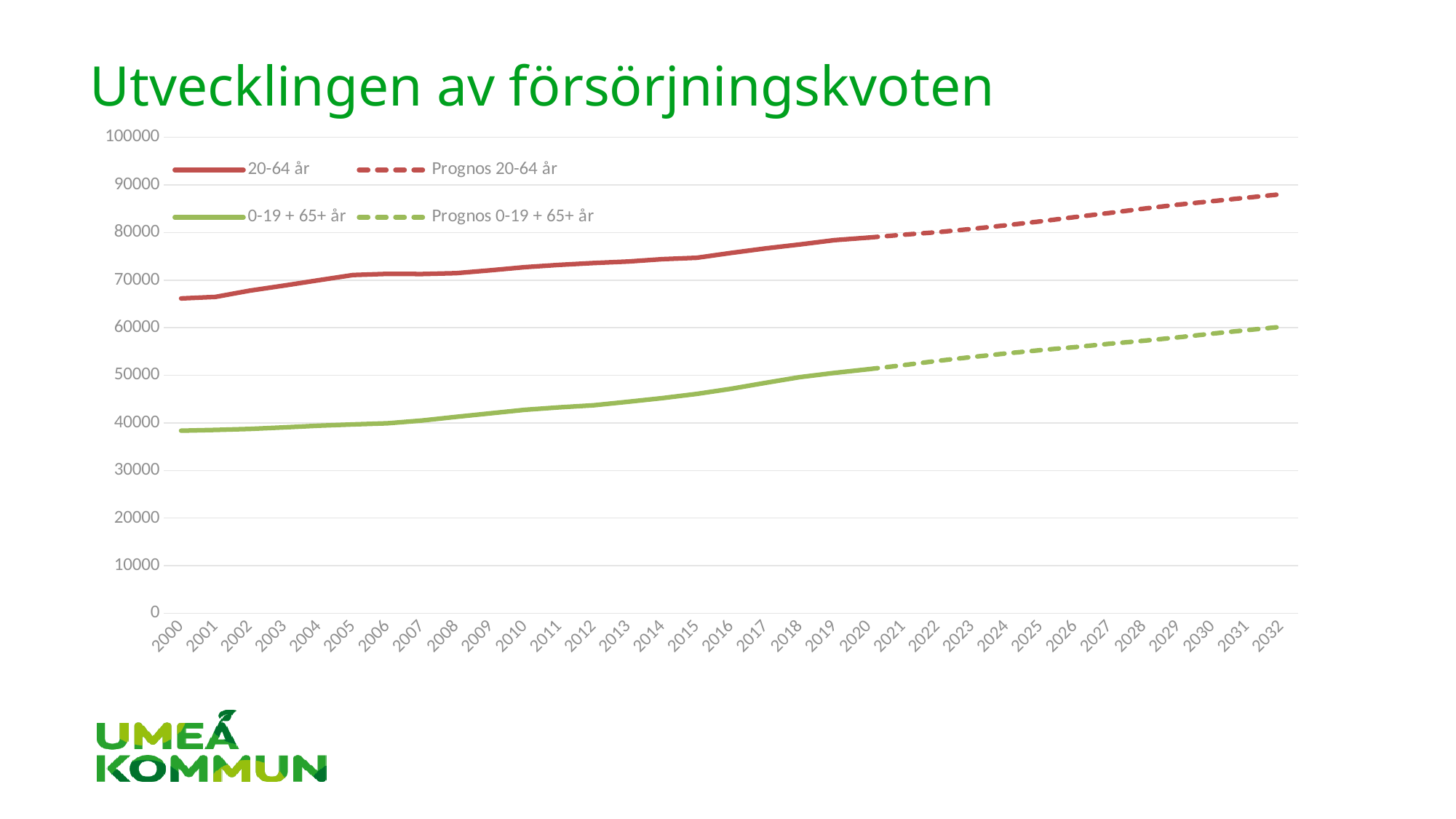
How many series does the legend list? 4 Is the value for Prognos 20-64 år in 2032 greater or less than 80000? greater Which legend entry is drawn as a dashed red line? Prognos 20-64 år Does the 0-19 + 65+ år line rise or fall from 2000 to 2020? rise Does the 20-64 år line rise or fall from 2000 to 2020? rise In 2010, which is larger: the value for 20-64 år or the value for 0-19 + 65+ år? 20-64 år How many years are shown on the x axis? 33 What is the title of the slide? Utvecklingen av försörjningskvoten Is the value for Prognos 0-19 + 65+ år in 2032 greater or less than 50000? greater Is the value for 20-64 år in 2000 greater or less than 60000? greater What kind of chart is shown on the slide? line chart